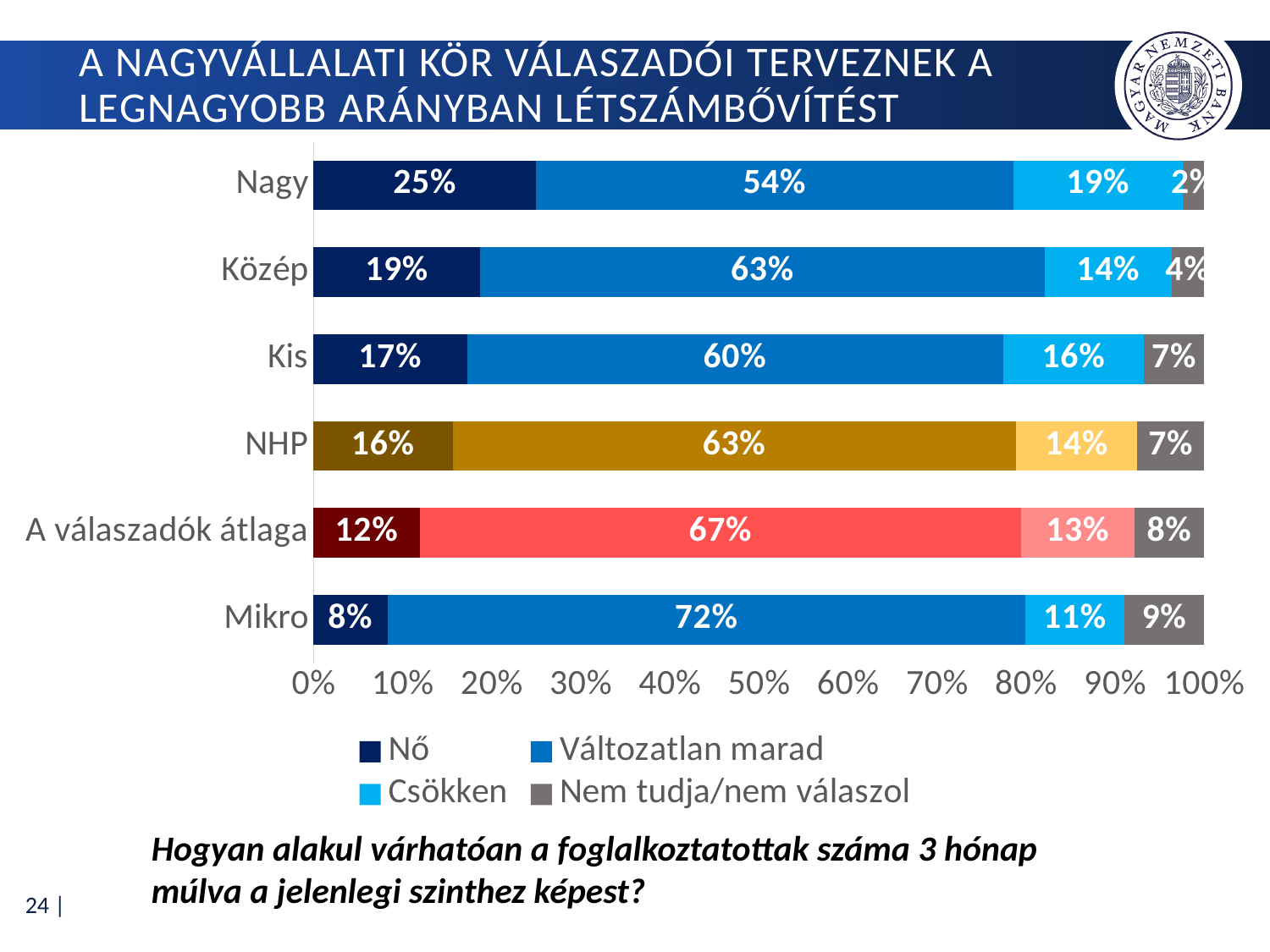
How many categories are shown on the chart? 6 Which category has the highest 'Nő' value? Nagy How many series does the legend list? 4 Which category has the lowest 'Nő' value? Mikro What is the difference between the 'Változatlan marad' values for Mikro and Nagy? 18% What is the 'Változatlan marad' value for the Mikro category? 72% What is the 'Nő' value for the Nagy category? 25% What is the 'Csökken' value for the Kis category? 16% Which is larger, the 'Csökken' value for Nagy or for Közép? Nagy Which category has the highest 'Változatlan marad' value? Mikro What is the 'Nem tudja/nem válaszol' value for A válaszadók átlaga? 8% What kind of chart is shown on the slide? Stacked bar chart